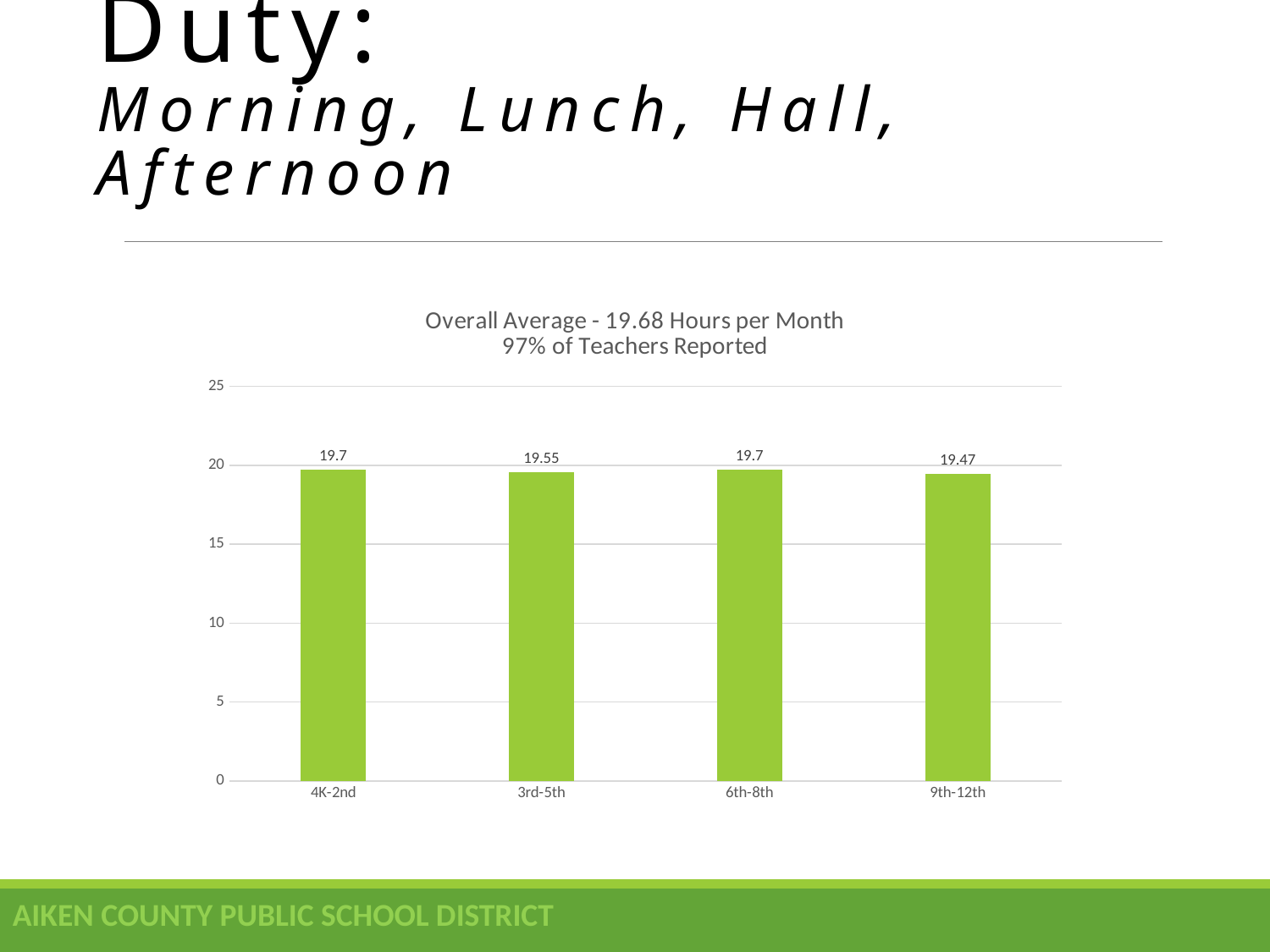
What is the value for 4K-2nd? 19.7 According to the chart title, what percentage of teachers reported? 97% Is the value for 6th-8th greater or less than 20? less What overall average is stated in the chart title? 19.68 Hours per Month How many categories are shown on the x axis? 4 What is the value for 3rd-5th? 19.55 Which is larger, the value for 3rd-5th or the value for 9th-12th? 3rd-5th What is the value for 9th-12th? 19.47 What kind of chart is shown on the slide? bar chart Which category has the lowest value? 9th-12th What is the difference between the values for 4K-2nd and 9th-12th? 0.23 What is the difference between the values for 6th-8th and 3rd-5th? 0.15